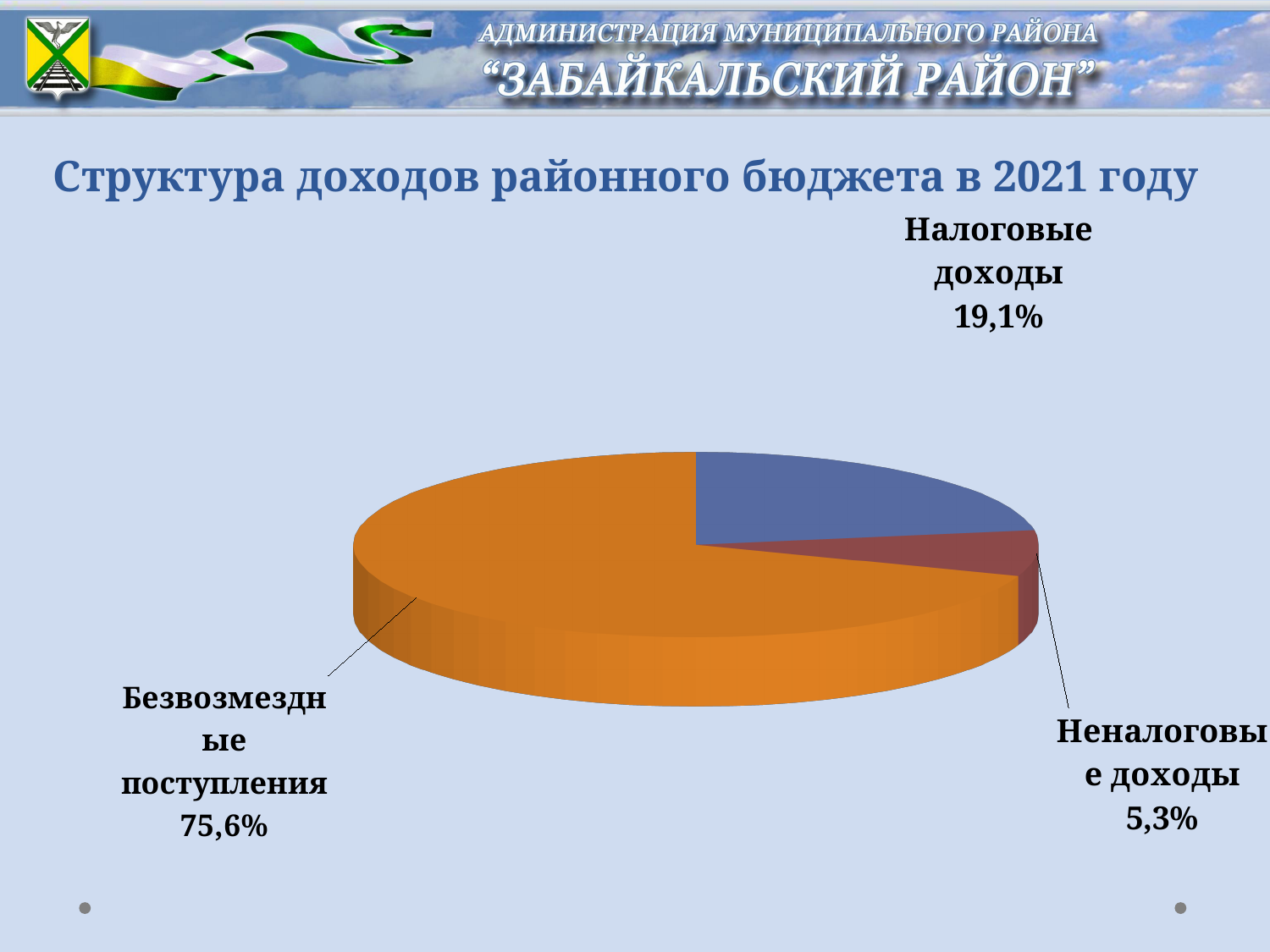
Which category has the smallest share of the pie? Неналоговые доходы What share of the district budget revenue comes from Неналоговые доходы? 5,3% What is the difference in percentage points between Безвозмездные поступления and Налоговые доходы? 56,5 What share of the district budget revenue comes from Безвозмездные поступления? 75,6% Which category has the largest share of the pie? Безвозмездные поступления What is the title of the chart on the slide? Структура доходов районного бюджета в 2021 году What share of the district budget revenue comes from Налоговые доходы? 19,1% Which is larger: the share of Налоговые доходы or the share of Неналоговые доходы? Налоговые доходы What type of chart is shown on the slide? Pie chart What colour is the slice for Безвозмездные поступления? Orange How many categories are shown in the pie chart? 3 What is the difference in percentage points between Налоговые доходы and Неналоговые доходы? 13,8